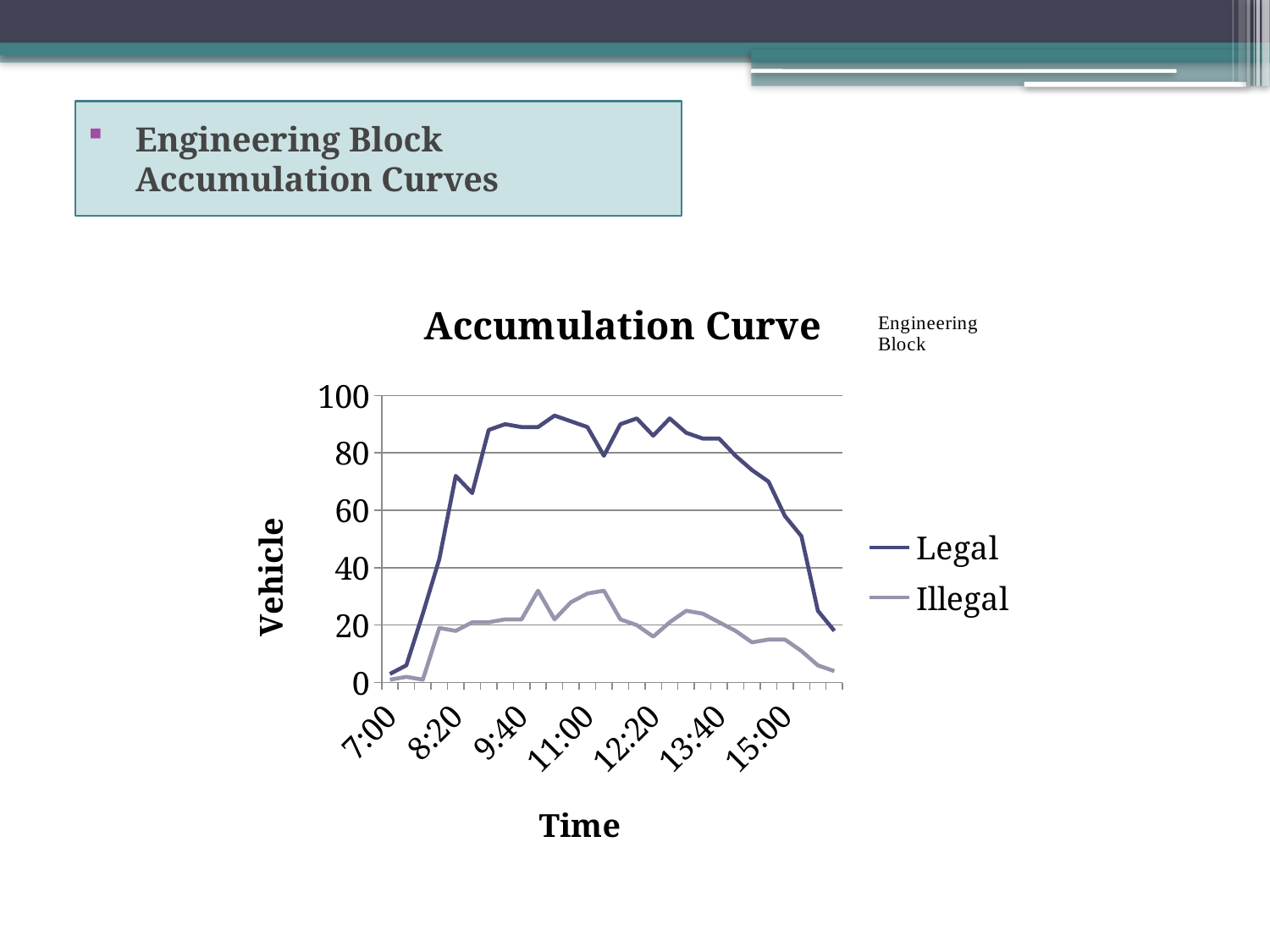
Is the Illegal value at 11:00 greater or less than 20? greater Is the Illegal value at 15:00 greater or less than 20? less At 11:00, which series has the larger value, Legal or Illegal? Legal What is the title of the chart on the slide? Accumulation Curve Is the Legal value at 7:00 greater or less than 20? less What kind of chart is shown on the slide? line chart What are the two series named in the legend of the Accumulation Curve chart? Legal and Illegal How many series does the legend of the Accumulation Curve chart list? 2 How many time labels are shown on the x axis of the chart? 7 Which series stays higher across the whole time range, Legal or Illegal? Legal